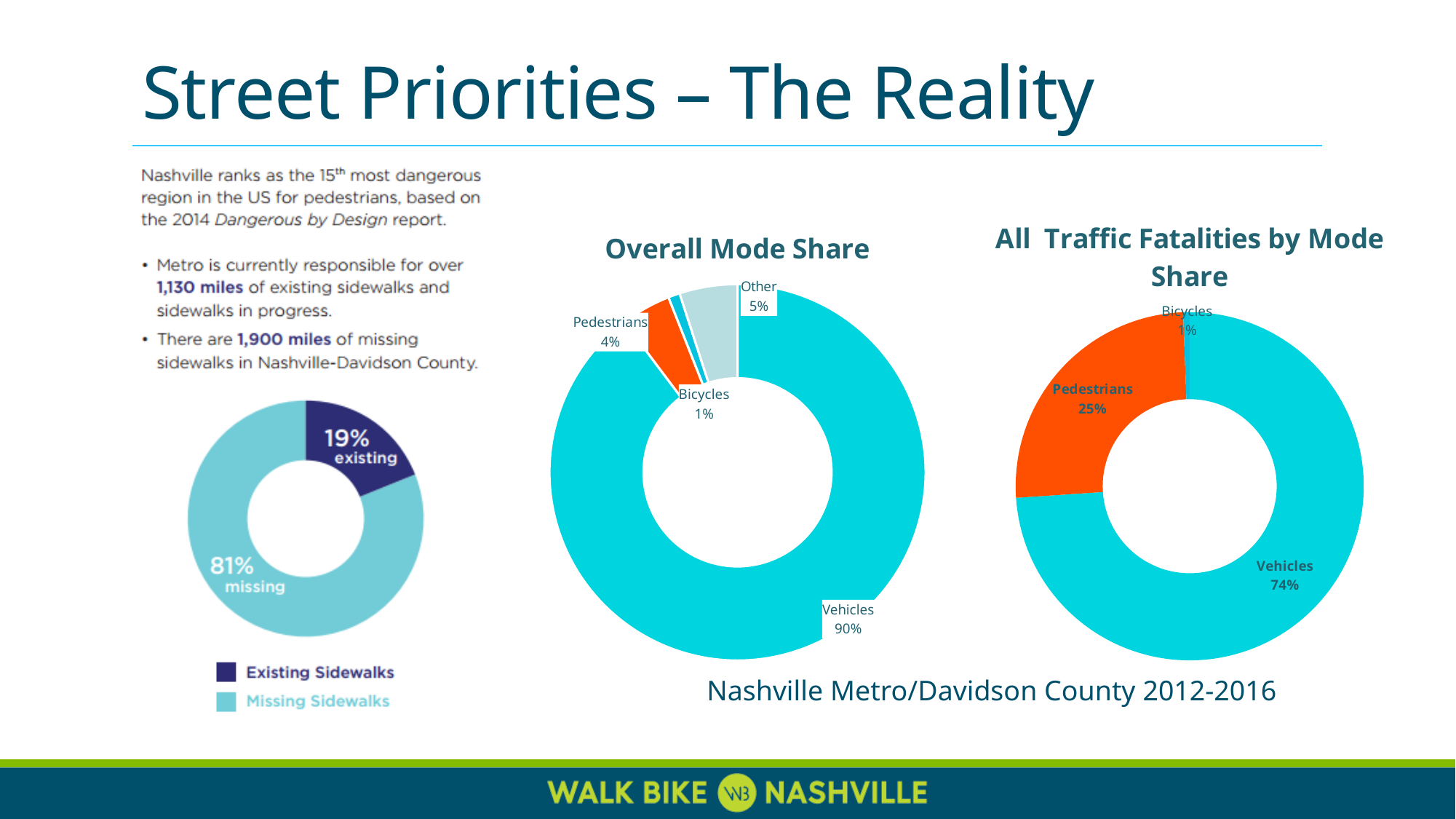
In the All Traffic Fatalities by Mode Share chart, what is the difference between the Vehicles share and the Pedestrians share? 49% In the All Traffic Fatalities by Mode Share chart, which category has the smallest share? Bicycles In the All Traffic Fatalities by Mode Share chart, what is the share for Pedestrians? 25% In the All Traffic Fatalities by Mode Share chart, what is the share for Vehicles? 74% In the sidewalks chart on the left, what percentage of sidewalks is missing? 81% In the sidewalks chart on the left, which is larger, Existing Sidewalks or Missing Sidewalks? Missing Sidewalks In the Overall Mode Share chart, which category has the largest share? Vehicles What type of chart is the All Traffic Fatalities by Mode Share chart? Donut (pie) chart In the Overall Mode Share chart, what is the share for Vehicles? 90% How many labeled categories does the Overall Mode Share chart show? 4 In the Overall Mode Share chart, what is the share for Other? 5% In the Overall Mode Share chart, what is the share for Pedestrians? 4%